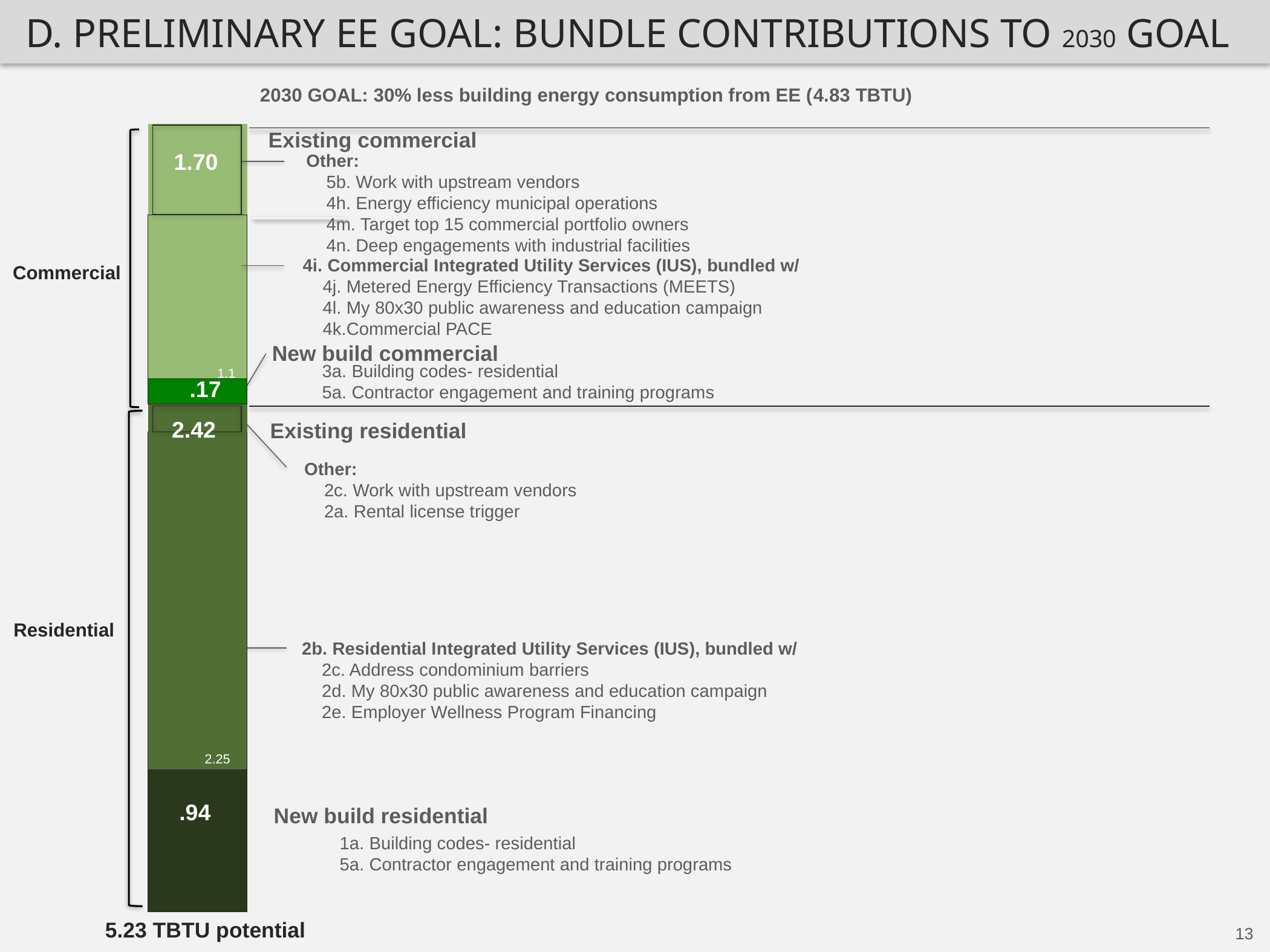
Which is larger, the New build residential segment or the New build commercial segment? New build residential What value is shown for the Existing commercial segment of the bar? 1.70 What value is shown for the New build commercial segment of the bar? .17 Which segment of the stacked bar has the smallest value? New build commercial Which segment of the stacked bar has the largest value? Existing residential What value is shown for the New build residential segment of the bar? .94 What total potential is stated below the bar? 5.23 TBTU potential What value is shown for the Existing residential segment of the bar? 2.42 What is the combined value of the two Commercial segments (1.70 and .17)? 1.87 What is the combined value of the two Residential segments (2.42 and .94)? 3.36 What is the difference between the Existing residential value (2.42) and the Existing commercial value (1.70)? 0.72